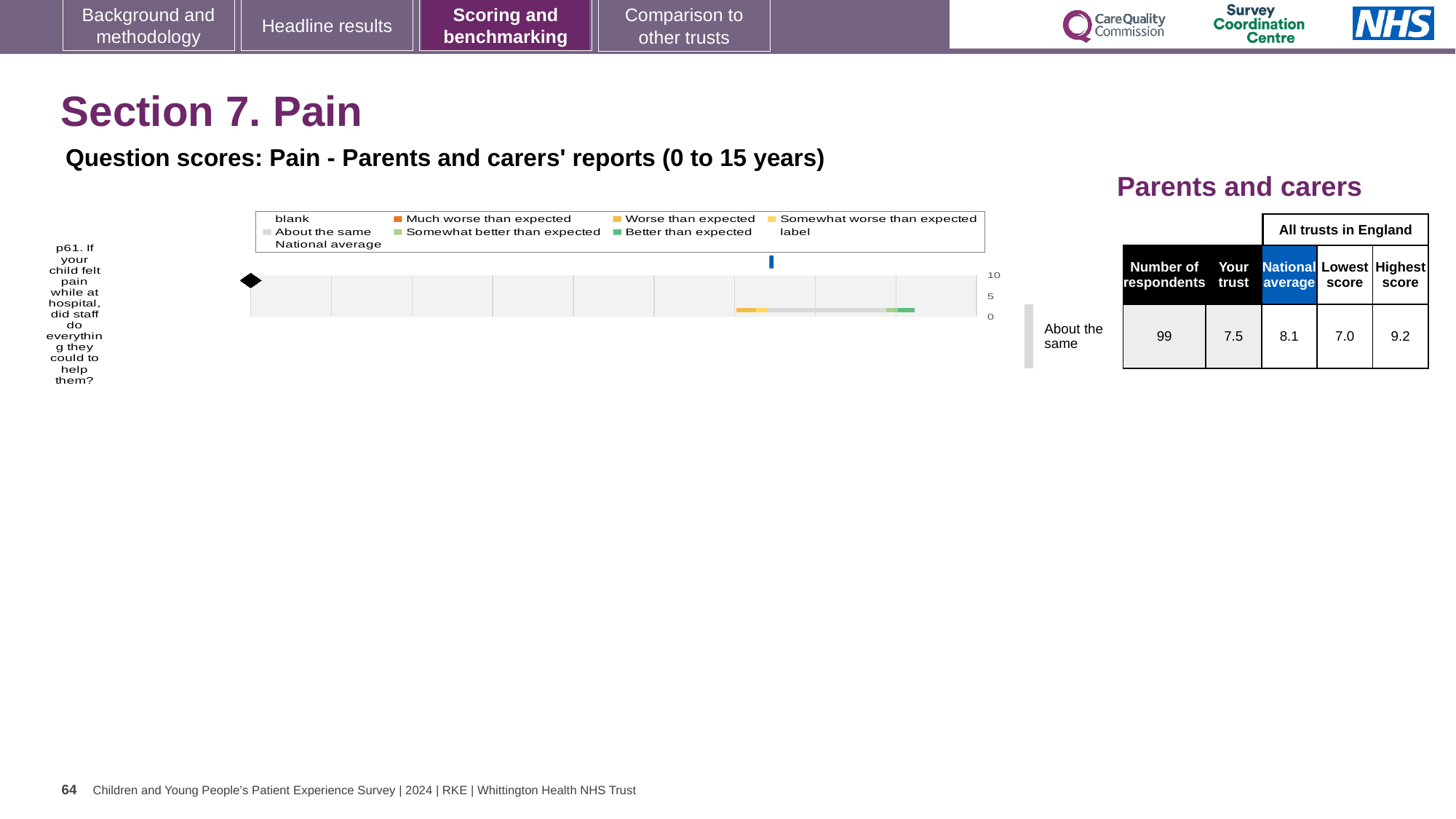
What is the difference between the highest score (9.2) and the lowest score (7.0) for question p61? 2.2 What kind of chart is shown on the slide? bar chart According to the table next to the chart, what is the score for 'Your trust' for question p61? 7.5 Which benchmarking category does the table assign to the trust's score for question p61? About the same How many survey questions (categories) are plotted in the chart? 1 According to the table next to the chart, what is the national average score for question p61? 8.1 According to the table, what is the lowest score among all trusts in England for question p61? 7.0 Is the national average marker on the chart for question p61 greater or less than 5? greater How many respondents answered question p61, according to the table? 99 What is the highest value shown on the chart's numeric axis? 10 Which is larger for question p61: the national average or the 'Your trust' score? National average According to the table, what is the highest score among all trusts in England for question p61? 9.2